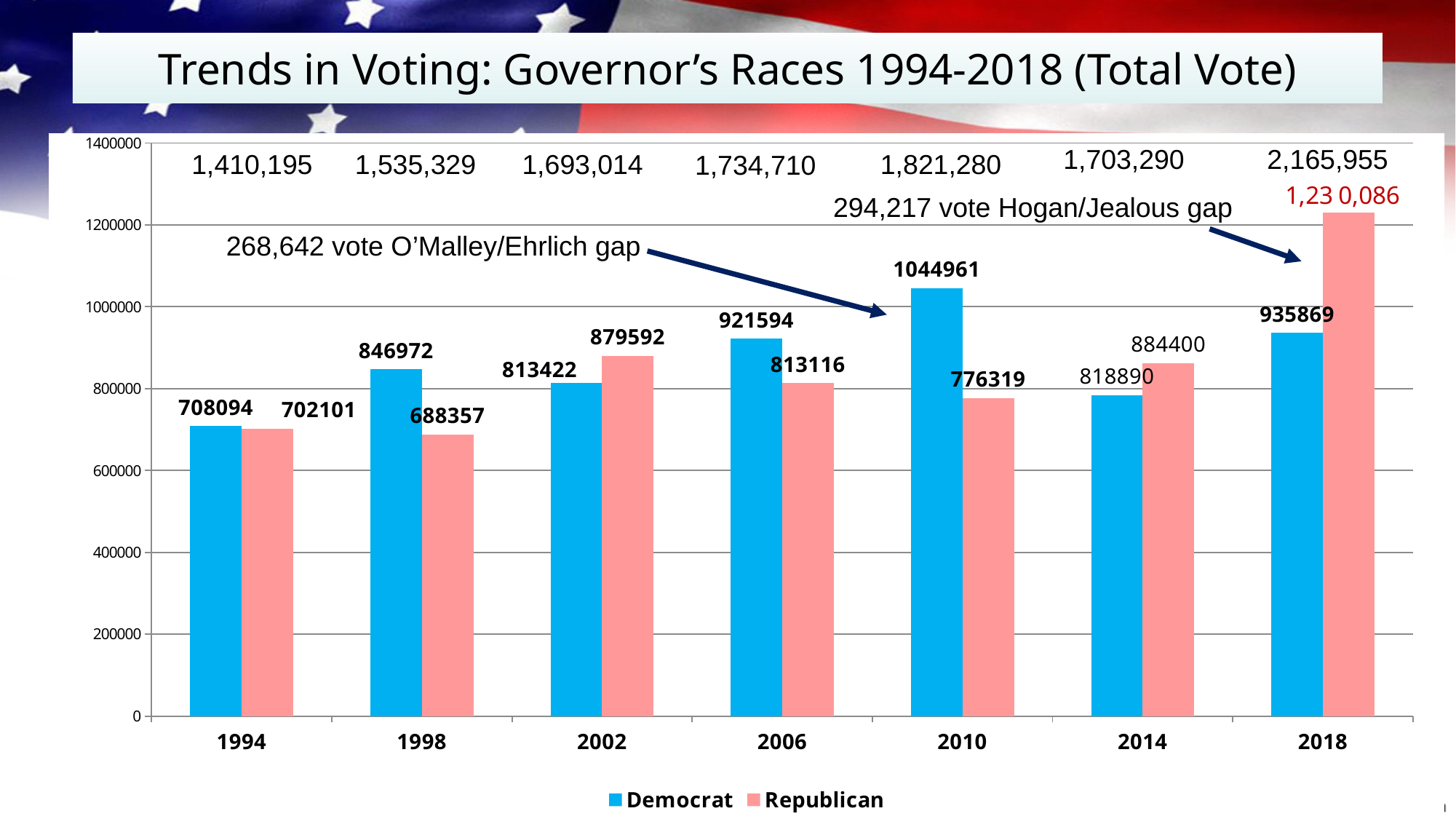
What is the difference between the Democrat and Republican votes in 1994? 5993 In which year was the Democrat vote the highest? 2010 In 2014, which party received more votes, Democrat or Republican? Republican How many series does the legend list? 2 What is the Democrat vote total shown for 2010? 1044961 What total vote figure is printed above the 2018 bars? 2,165,955 How many election years are shown on the x axis? 7 Is the Republican vote for 2018 greater or less than 1200000? greater What kind of chart is shown on the slide? bar chart In which year was the Republican vote the lowest? 1998 What is the Republican vote total shown for 2002? 879592 What is the difference between the Democrat and Republican votes in 2010? 268642